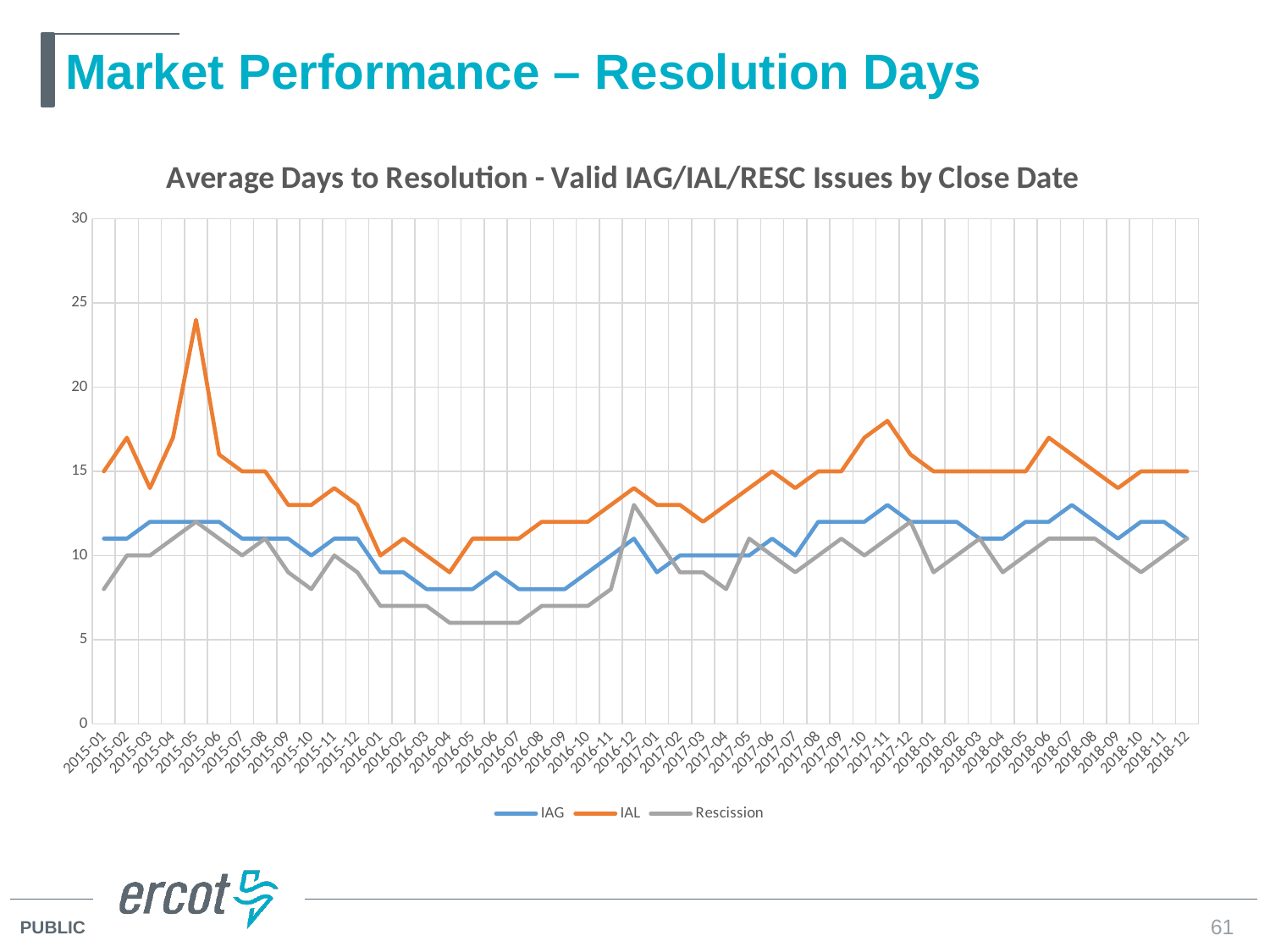
How many series does the legend list? 3 Is the Rescission value for 2016-05 greater or less than 10? less Which series reaches the highest value anywhere on the chart? IAL Is the IAL value for 2015-05 greater or less than 20? greater Which is larger at 2015-05, the IAL value or the IAG value? IAL Is the IAL value for 2017-11 greater or less than 15? greater Which series is drawn in orange? IAL In which month does the IAL series reach its highest value? 2015-05 How many monthly points are plotted along the x axis? 48 What is the title of the chart? Average Days to Resolution - Valid IAG/IAL/RESC Issues by Close Date Does the IAL series rise or fall between 2015-05 and 2016-04? fall What kind of chart is shown on the slide? line chart